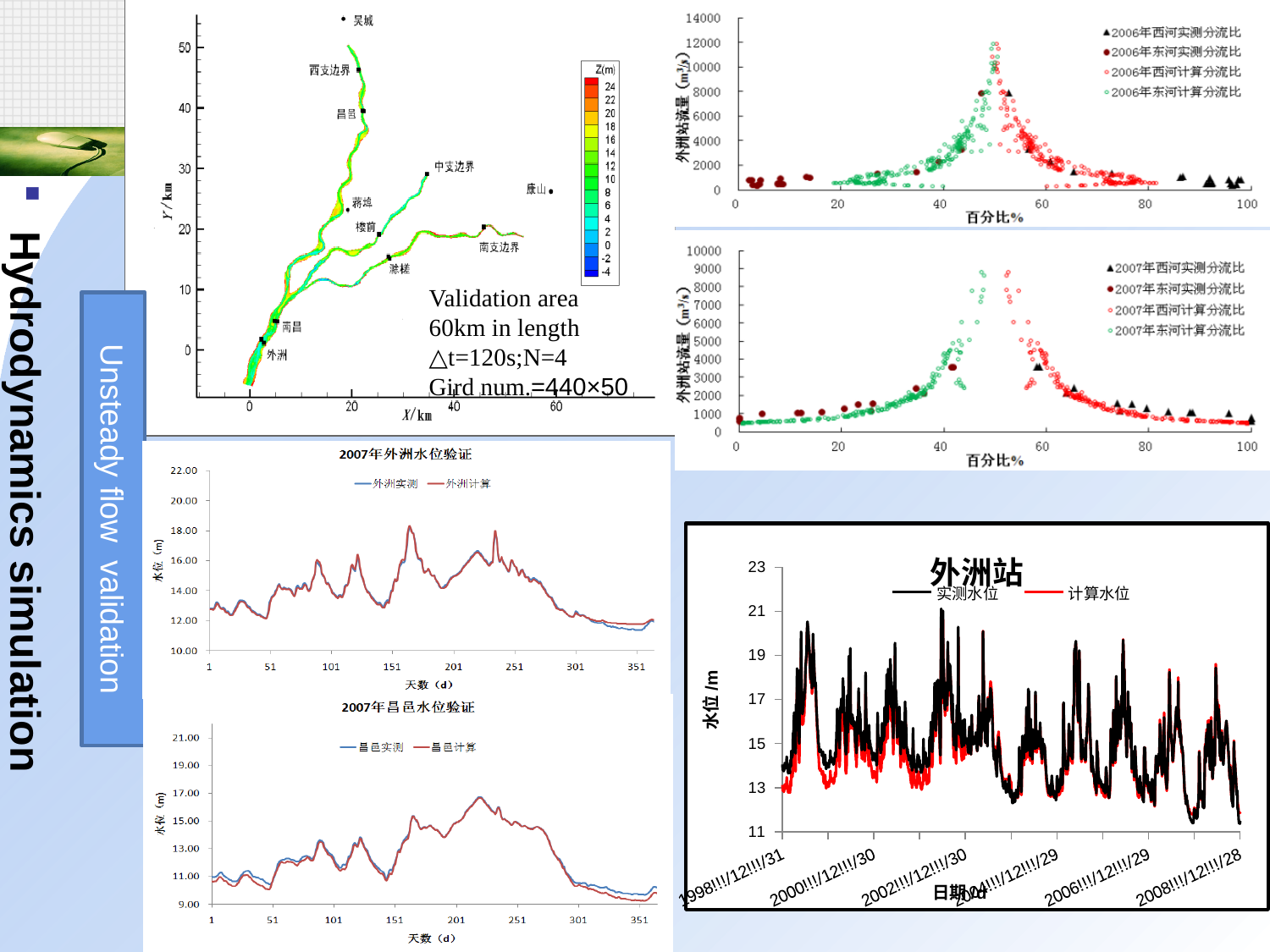
In the '2007年昌邑水位验证' chart, is the highest peak of the curves greater or less than 15.00? greater How many series does the legend of the '2007年外洲水位验证' chart list? 2 In the '2007年外洲水位验证' chart, is the water level at day 1 greater or less than 14.00? less What kind of chart is the 2007年 分流比 chart on the right side of the slide? scatter chart In the '外洲站' chart at the bottom right, which colour is used for the 计算水位 series? red In the '2007年昌邑水位验证' chart, is the water level at day 1 greater or less than 13.00? less How many series does the legend of the '外洲站' chart at the bottom right list? 2 What kind of chart is the '2007年外洲水位验证' chart? line chart What is the x-axis label of the '外洲站' chart at the bottom right? 日期 How many series does the legend of the top-right scatter chart (2006年 分流比) list? 4 What are the two legend entries of the '2007年昌邑水位验证' chart? 昌邑实测, 昌邑计算